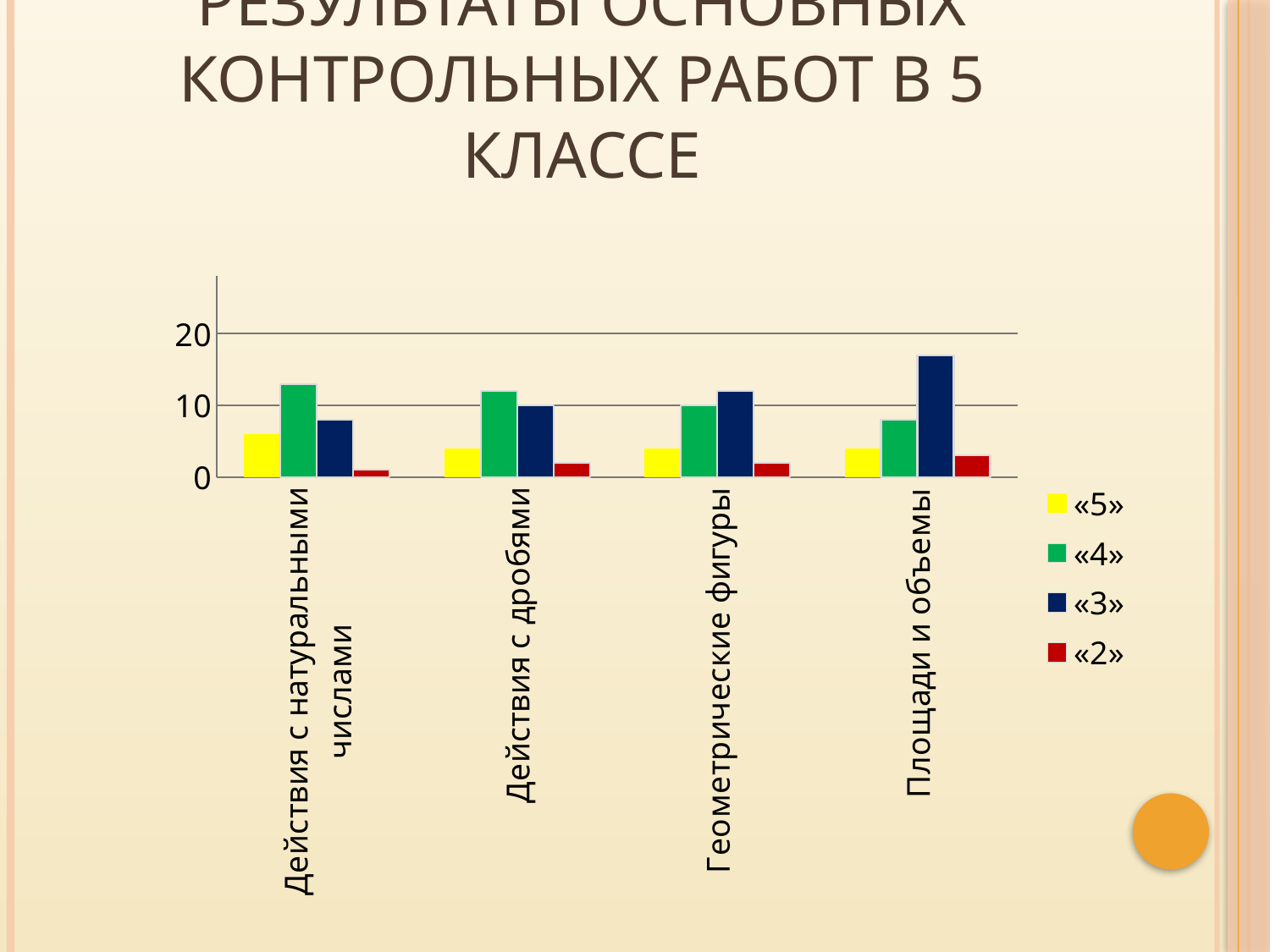
In which category is the «3» bar the highest? Площади и объемы What kind of chart is shown on the slide? bar chart How many categories are shown on the x axis of the chart? 4 How many series does the chart legend list? 4 In which category is the «2» bar the lowest? Действия с натуральными числами Is the value for «4» in the category Действия с натуральными числами greater or less than 10? greater Is the value for «2» in the category Геометрические фигуры greater or less than 10? less In the category Площади и объемы, which is larger: the «3» bar or the «4» bar? «3» Is the value for «5» in the category Действия с натуральными числами greater or less than 10? less In which category is the «4» bar the lowest? Площади и объемы What colour is used for the «2» series in the chart? red